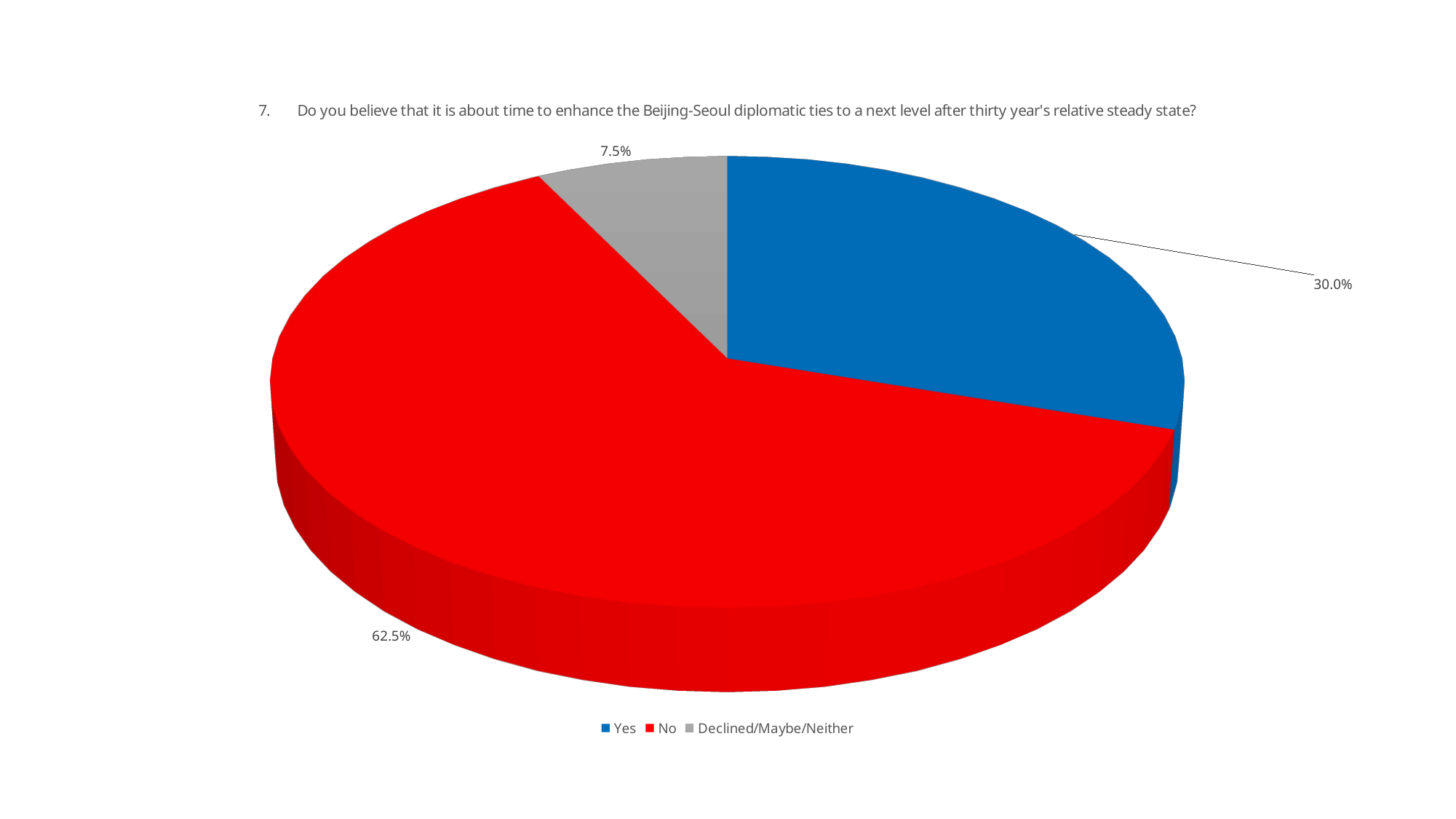
What percentage of respondents answered "No"? 62.5% How many slices does the pie chart have? 3 What percentage of respondents answered "Yes"? 30.0% Which response has the smallest share of the pie? Declined/Maybe/Neither What kind of chart is shown on the slide? Pie chart Which response has the largest share of the pie? No Which is larger, the share for "Yes" or the share for "Declined/Maybe/Neither"? Yes What is the difference in percentage points between the "No" and "Yes" shares? 32.5 What is the combined share of "Yes" and "Declined/Maybe/Neither"? 37.5% What colour is the "No" slice? Red How many entries does the legend list? 3 What percentage of respondents answered "Declined/Maybe/Neither"? 7.5%